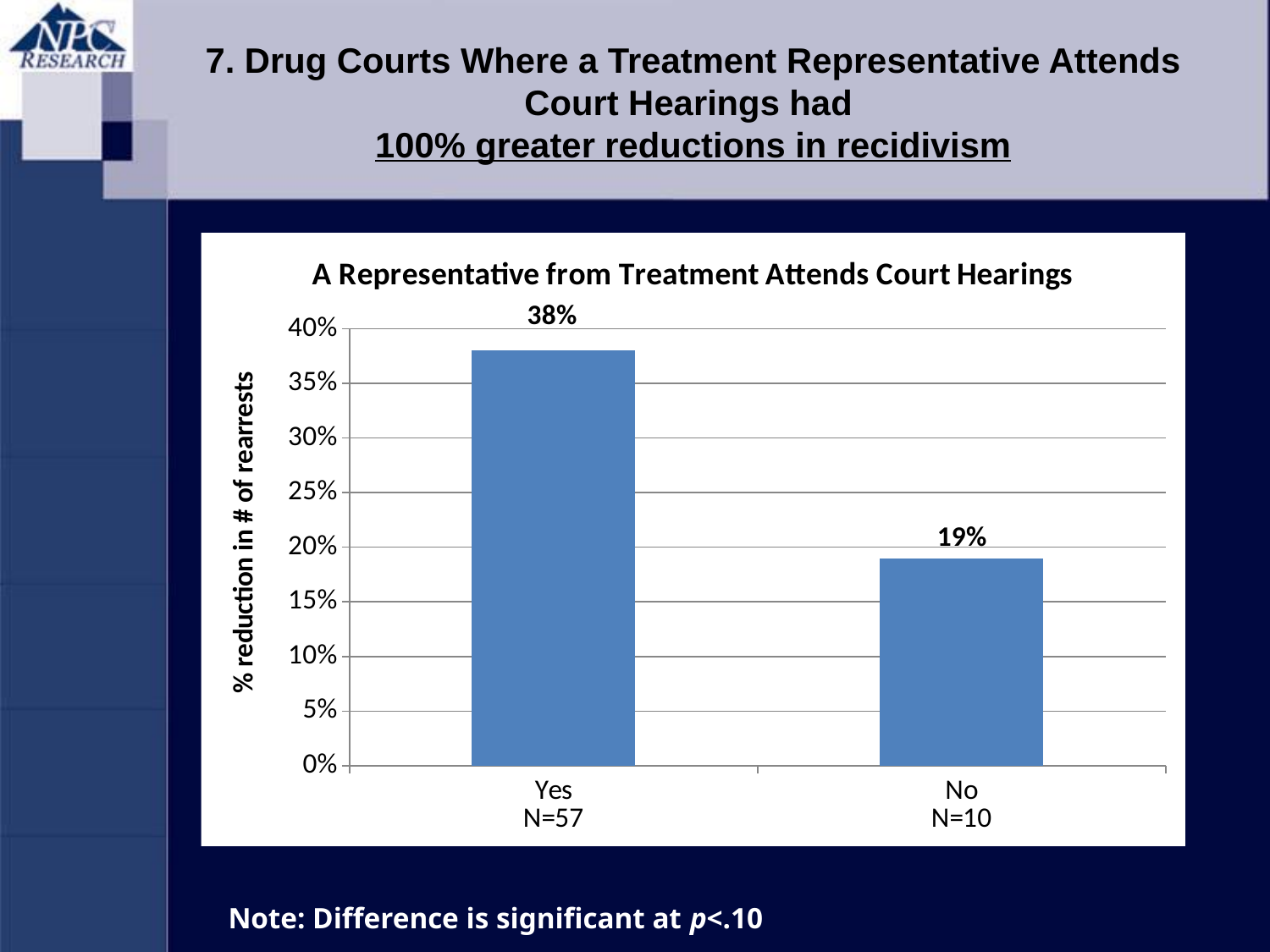
Is the value for "No" greater or less than 20%? less What is the difference in % reduction in # of rearrests between the "Yes" and "No" categories? 19% Which category has the lowest % reduction in # of rearrests? No Is the value for "Yes" greater or less than 35%? greater What is the % reduction in # of rearrests for the "Yes" category? 38% What is the title of the chart? A Representative from Treatment Attends Court Hearings How many categories are shown on the x axis of the chart? 2 What kind of chart is shown on the slide? Bar chart Which has a larger % reduction in # of rearrests, "Yes" or "No"? Yes What is the % reduction in # of rearrests for the "No" category? 19% Which category has the highest % reduction in # of rearrests? Yes What is the label of the y axis of the chart? % reduction in # of rearrests